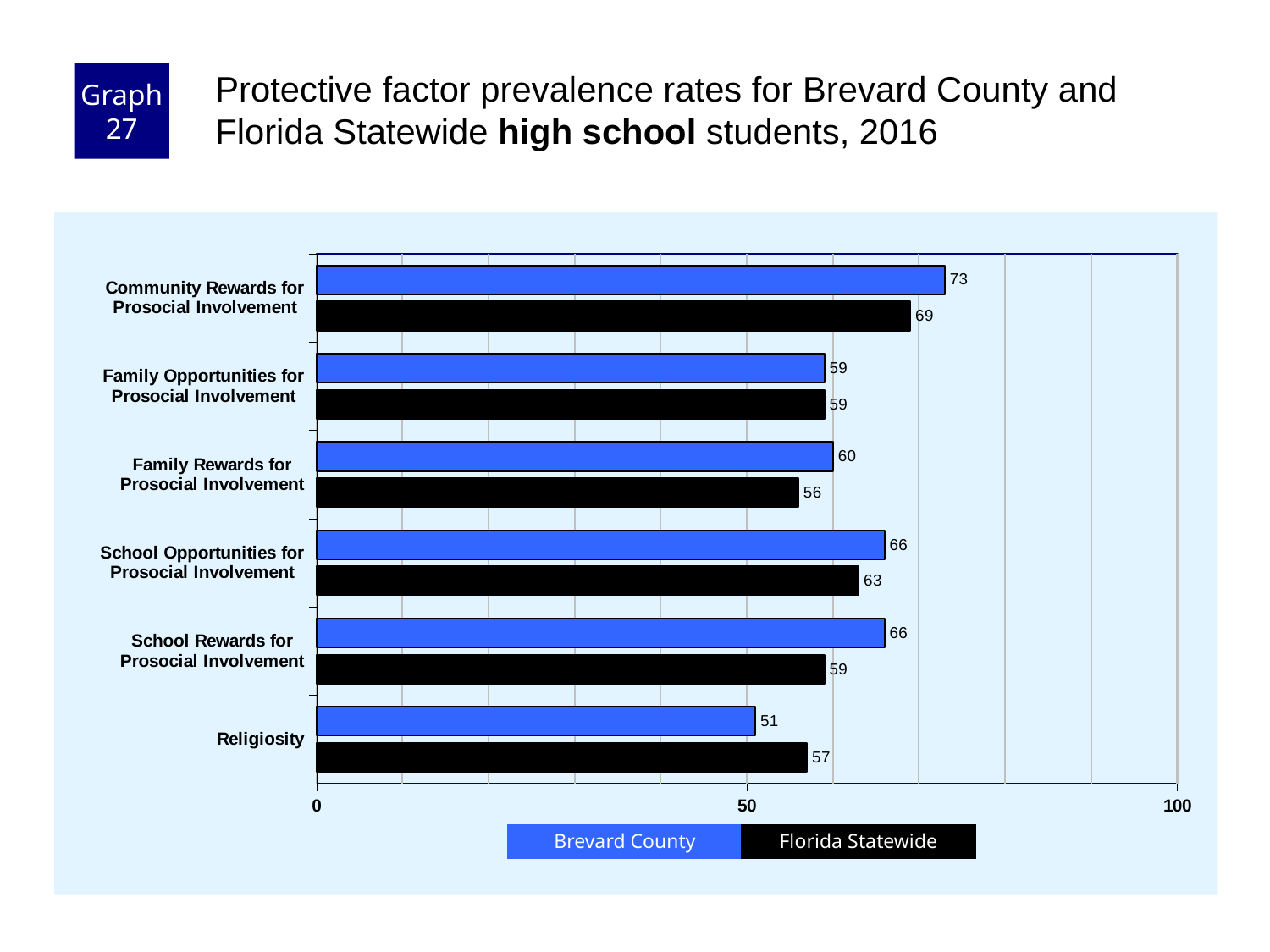
What kind of chart is shown on the slide? bar chart Which colour represents Florida Statewide in the chart? black What is the Florida Statewide value for Religiosity? 57 Which category has the highest Brevard County value? Community Rewards for Prosocial Involvement Is the Brevard County value for Family Rewards for Prosocial Involvement greater or less than 50? greater How many series does the legend list? 2 What is the difference between the Brevard County and Florida Statewide values for School Rewards for Prosocial Involvement? 7 Which category has the lowest Brevard County value? Religiosity For Religiosity, which is larger: the Brevard County value or the Florida Statewide value? Florida Statewide What is the Brevard County value for Community Rewards for Prosocial Involvement? 73 What is the Florida Statewide value for School Opportunities for Prosocial Involvement? 63 How many categories are shown on the chart? 6